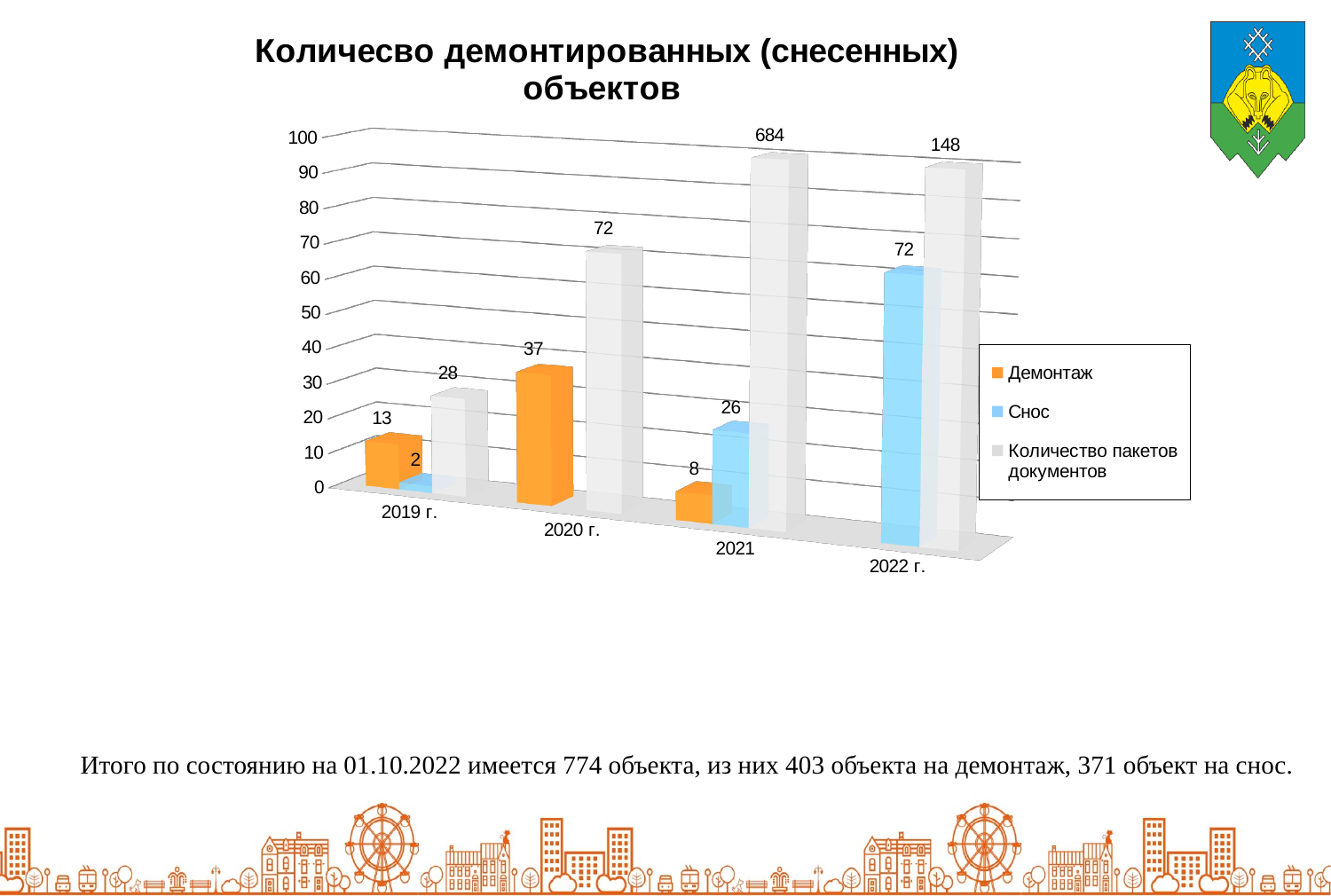
What is the value for Демонтаж in 2019 г.? 13 How many series does the legend list? 3 What is the value for Снос in 2022 г.? 72 What is the value for Количество пакетов документов in 2021? 684 What is the difference between the Демонтаж values for 2020 г. and 2019 г.? 24 Which is larger: Снос in 2021 or Снос in 2022 г.? Снос in 2022 г. In which year is the Демонтаж value lowest? 2021 In which year is the Демонтаж value highest? 2020 г. What is the value for Снос in 2021? 26 What kind of chart is shown on the slide? Bar chart How many year categories are shown on the x axis? 4 What is the value for Количество пакетов документов in 2020 г.? 72